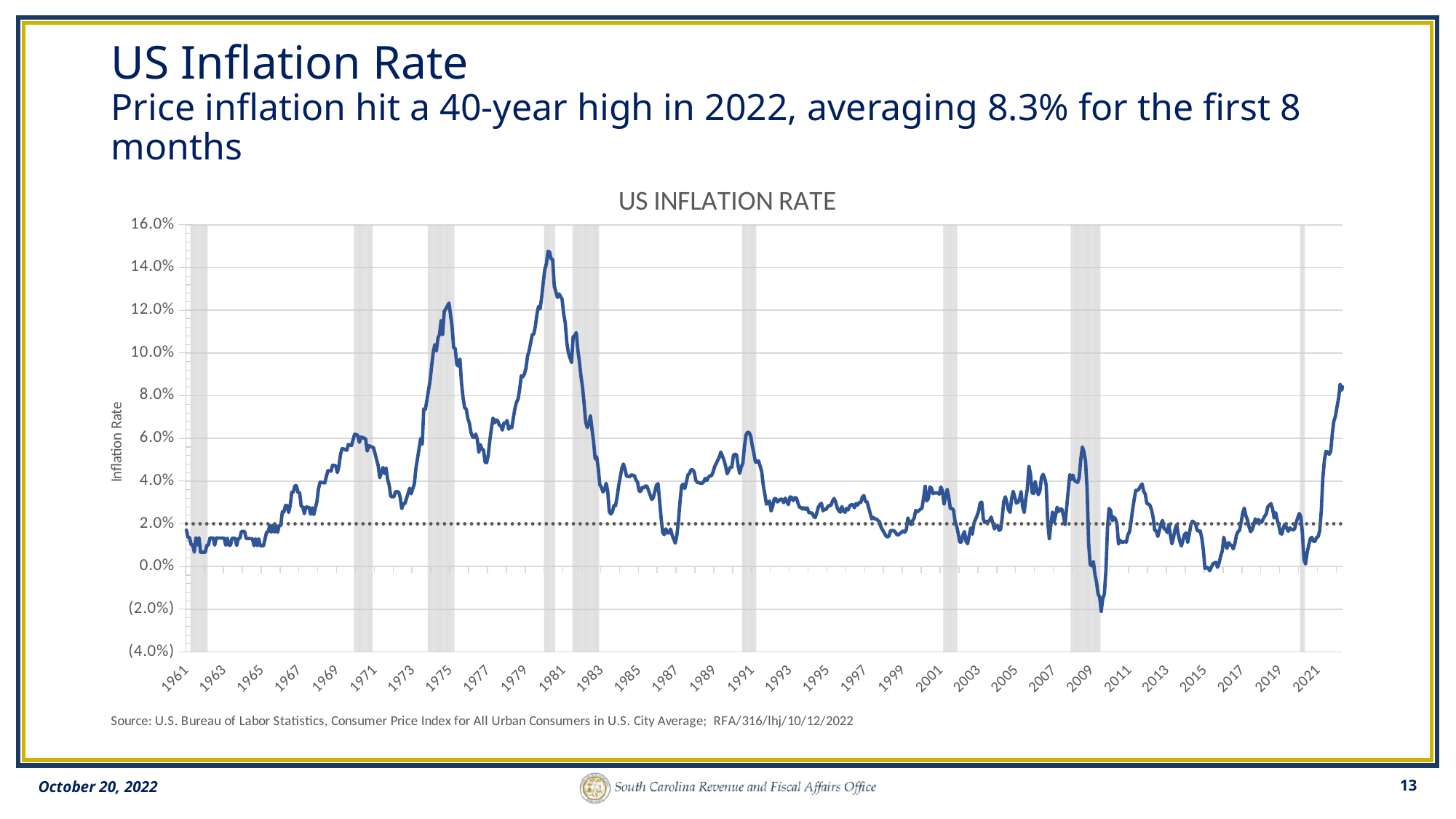
Is the peak inflation rate around 1980 greater or less than 14.0%? greater What is the label on the vertical axis of the chart? Inflation Rate In which year does the inflation rate reach its highest peak on the chart? 1980 Is the lowest inflation rate around 2009 greater or less than 0.0%? less Does the inflation rate rise or fall between 2020 and 2022? rise Does the inflation rate rise or fall between 1980 and 1983? fall Is the inflation rate at the end of the series in 2022 greater or less than 6.0%? greater Around which year does the inflation rate reach its lowest point on the chart? 2009 What is the title of the chart? US INFLATION RATE What kind of chart is shown on the slide? line chart